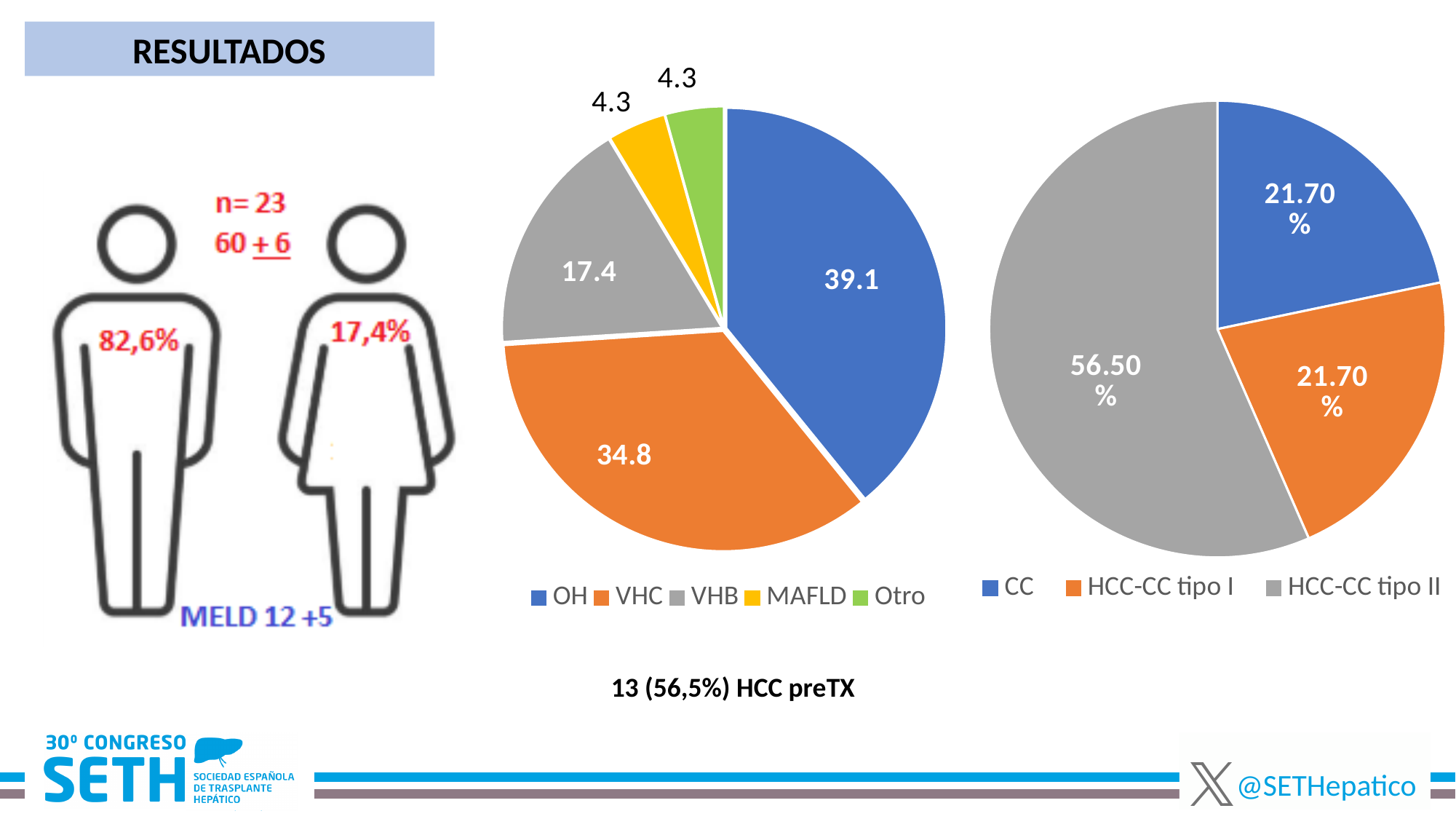
In the left pie chart (legend OH, VHC, VHB, MAFLD, Otro), what is the value for VHB? 17.4 In the left pie chart (legend OH, VHC, VHB, MAFLD, Otro), how many categories are shown? 5 In the right pie chart (legend CC, HCC-CC tipo I, HCC-CC tipo II), what is the value for CC? 21.70% In the left pie chart (legend OH, VHC, VHB, MAFLD, Otro), which category has the largest slice? OH In the left pie chart (legend OH, VHC, VHB, MAFLD, Otro), what is the value for OH? 39.1 In the left pie chart (legend OH, VHC, VHB, MAFLD, Otro), what is the value for MAFLD? 4.3 In the right pie chart (legend CC, HCC-CC tipo I, HCC-CC tipo II), which category has the largest slice? HCC-CC tipo II In the right pie chart (legend CC, HCC-CC tipo I, HCC-CC tipo II), how many categories does the legend list? 3 In the right pie chart (legend CC, HCC-CC tipo I, HCC-CC tipo II), what is the value for HCC-CC tipo II? 56.50% In the right pie chart (legend CC, HCC-CC tipo I, HCC-CC tipo II), what colour is the HCC-CC tipo I slice? Orange In the left pie chart (legend OH, VHC, VHB, MAFLD, Otro), what is the difference between the OH and VHC values? 4.3 What type of chart is the right chart (legend CC, HCC-CC tipo I, HCC-CC tipo II)? Pie chart